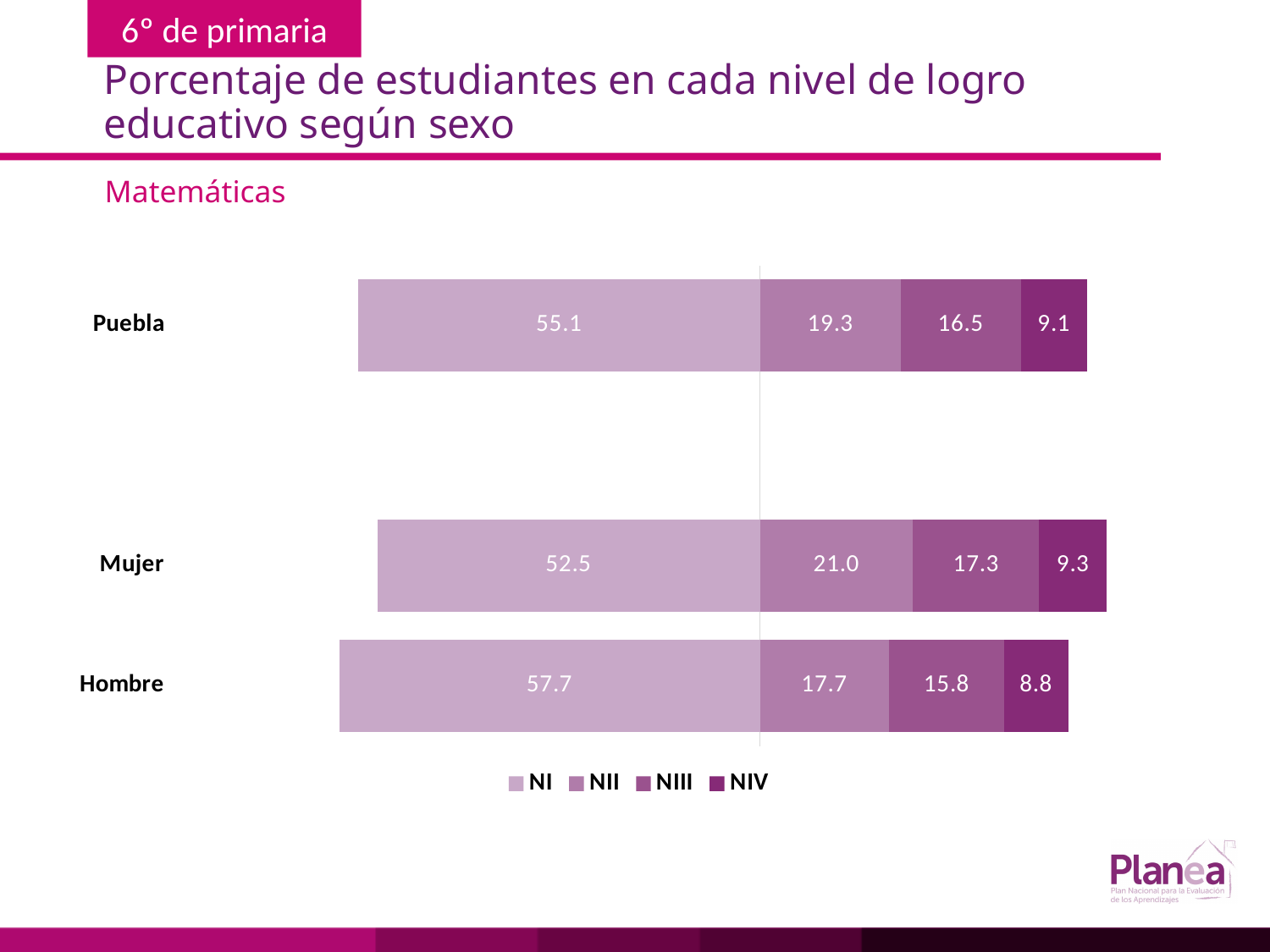
What is the NIII value for Mujer? 17.3 Which is larger, the NII value for Mujer or the NII value for Puebla? Mujer What is the NI value for Puebla? 55.1 What is the NII value for Hombre? 17.7 What is the difference between the NI values for Hombre and Mujer? 5.2 What is the total of the stacked bar for Puebla? 100.0 Which category has the highest NI value? Hombre How many series does the legend list? 4 Which category has the lowest NIV value? Hombre How many categories are shown on the chart? 3 What is the NIV value for Mujer? 9.3 What kind of chart is shown? Stacked bar chart